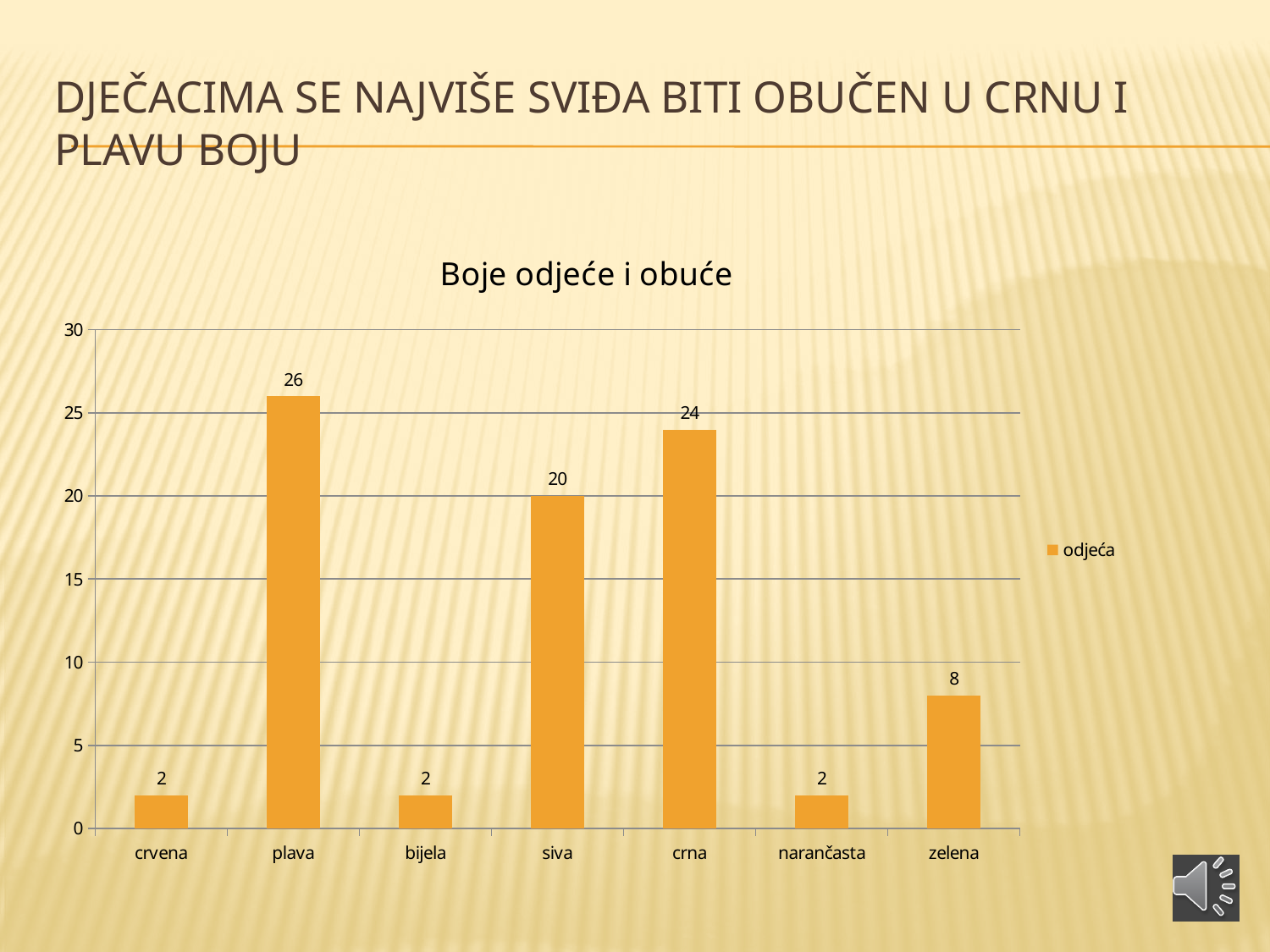
Which is larger, the value for siva or the value for crna? crna What is the title of the chart? Boje odjeće i obuće What is the difference between the values for siva and zelena? 12 What is the value for siva? 20 What is the value for crna? 24 How many categories are shown on the x axis? 7 What is the value for zelena? 8 Is the value for zelena greater or less than 10? less Which category has the highest value? plava How many series does the legend list? 1 What is the difference between the values for plava and crna? 2 What is the value for plava? 26